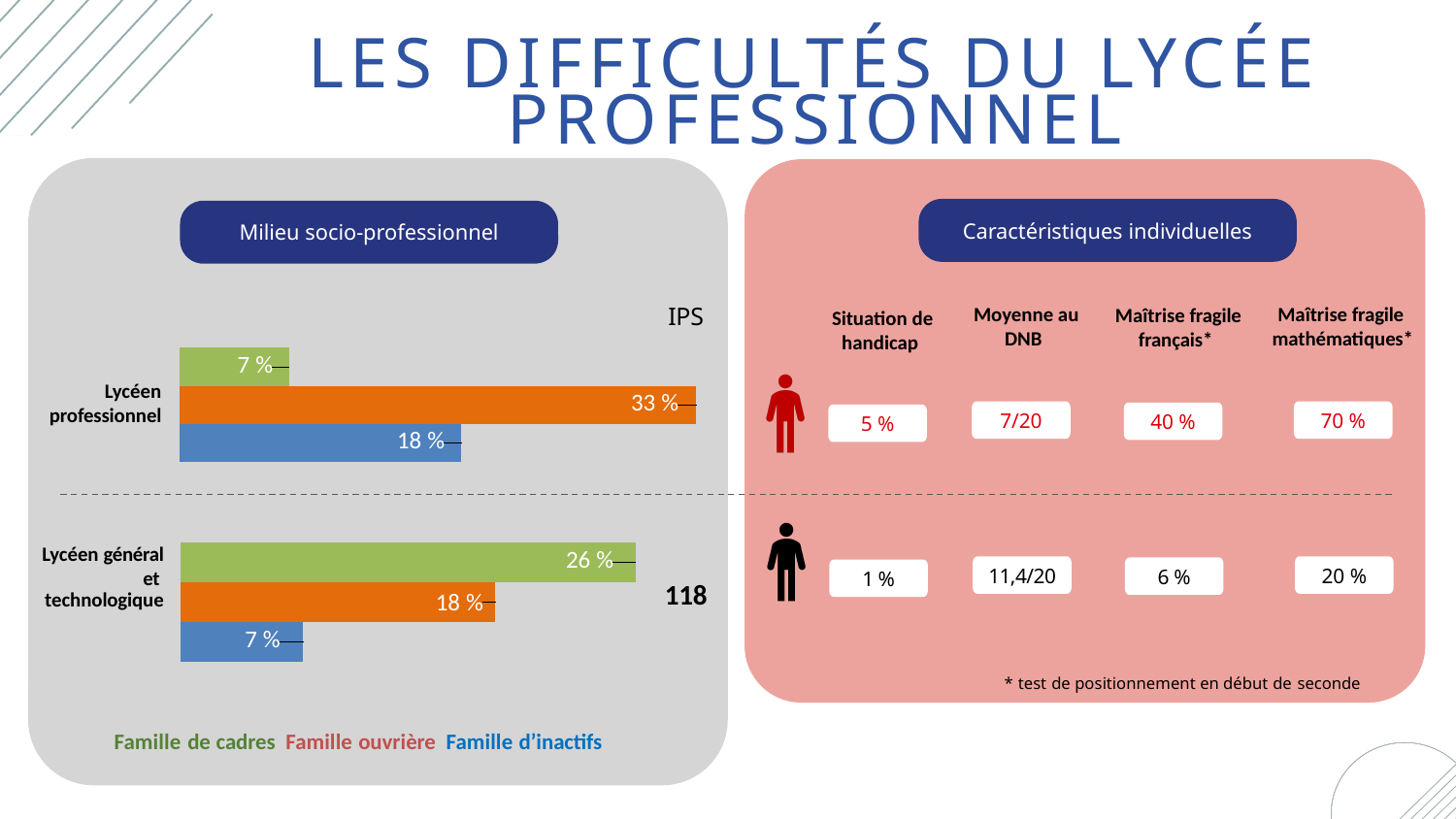
In the Milieu socio-professionnel chart, which family type has the highest value among Lycéen professionnel? Famille ouvrière In the Milieu socio-professionnel chart, which family type has the lowest value among Lycéen général et technologique? Famille d'inactifs In the Milieu socio-professionnel chart, what is the value for Famille de cadres among Lycéen professionnel? 7 % In the Milieu socio-professionnel chart, what is the value for Famille ouvrière among Lycéen professionnel? 33 % In the Milieu socio-professionnel chart, what is the difference between the Famille ouvrière values for Lycéen professionnel and Lycéen général et technologique? 15 % In the Milieu socio-professionnel chart, which is larger: Famille de cadres for Lycéen professionnel or Famille de cadres for Lycéen général et technologique? Lycéen général et technologique What kind of chart is the Milieu socio-professionnel chart? Bar chart How many series does the legend of the Milieu socio-professionnel chart list? 3 In the Milieu socio-professionnel chart, what colour represents Famille ouvrière? Orange In the Milieu socio-professionnel chart, what is the value for Famille d'inactifs among Lycéen général et technologique? 7 % In the Milieu socio-professionnel chart, what is the value for Famille de cadres among Lycéen général et technologique? 26 % In the Milieu socio-professionnel chart, what is the value for Famille d'inactifs among Lycéen professionnel? 18 %